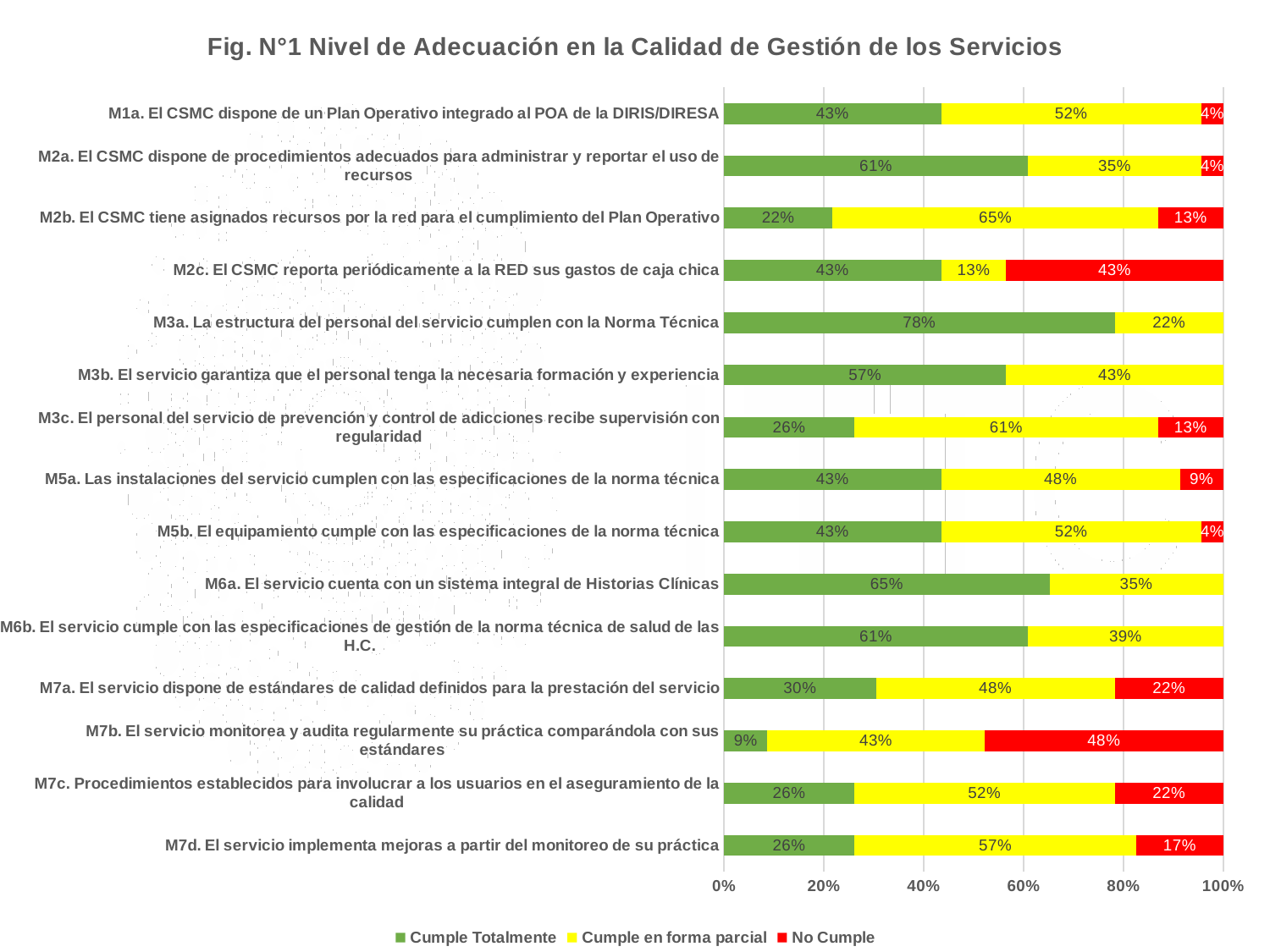
Which has the larger 'Cumple Totalmente' value, M2a or M2b? M2a Which indicator has the highest 'Cumple Totalmente' value? M3a. La estructura del personal del servicio cumplen con la Norma Técnica What is the difference between the 'Cumple Totalmente' values for M3a and M7b? 69 percentage points What is the 'Cumple en forma parcial' value for M2b. El CSMC tiene asignados recursos por la red para el cumplimiento del Plan Operativo? 65% How many categories (indicators) are plotted in the chart? 15 What kind of chart is shown on the slide? Stacked bar chart What is the title of the chart? Fig. N°1 Nivel de Adecuación en la Calidad de Gestión de los Servicios Which indicator has the highest 'No Cumple' value? M7b. El servicio monitorea y audita regularmente su práctica comparándola con sus estándares Which indicator has the lowest 'Cumple Totalmente' value? M7b. El servicio monitorea y audita regularmente su práctica comparándola con sus estándares How many series does the legend list? 3 What is the 'No Cumple' value for M7b. El servicio monitorea y audita regularmente su práctica comparándola con sus estándares? 48% What is the 'Cumple Totalmente' value for M3a. La estructura del personal del servicio cumplen con la Norma Técnica? 78%